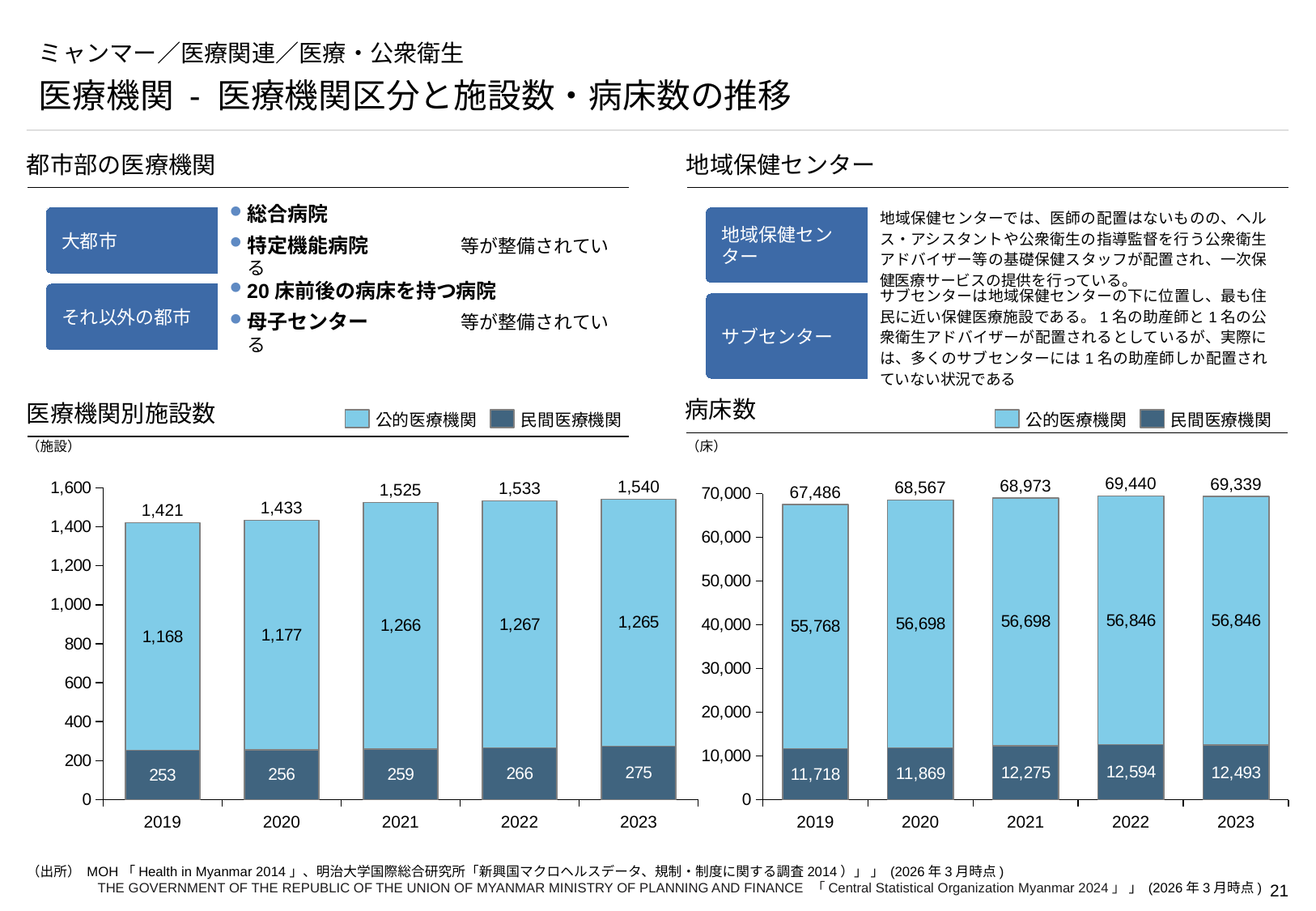
「病床数」のグラフの凡例には、いくつの系列が示されていますか？ 2 「医療機関別施設数」のグラフで、2023年と2019年の公的医療機関の施設数の差はいくつですか？ 97 「医療機関別施設数」のグラフで、2023年の民間医療機関の施設数はいくつですか？ 275 「医療機関別施設数」のグラフで、民間医療機関の施設数が最も多い年はどれですか？ 2023 「病床数」のグラフで、2022年の民間医療機関の病床数はいくつですか？ 12,594 「病床数」のグラフで、病床数の合計が最も少ない年はどれですか？ 2019 「医療機関別施設数」のグラフで、2021年の公的医療機関の施設数はいくつですか？ 1,266 「医療機関別施設数」のグラフで、2019年の施設数の合計はいくつですか？ 1,421 「医療機関別施設数」のグラフで、2019年から2023年にかけて施設数の合計は増加していますか、減少していますか？ 増加 「病床数」のグラフで、2020年の公的医療機関の病床数はいくつですか？ 56,698 「病床数」のグラフで、2023年の公的医療機関と民間医療機関の病床数の差はいくつですか？ 44,353 「病床数」のグラフで、2022年と2023年の民間医療機関の病床数はどちらが多いですか？ 2022